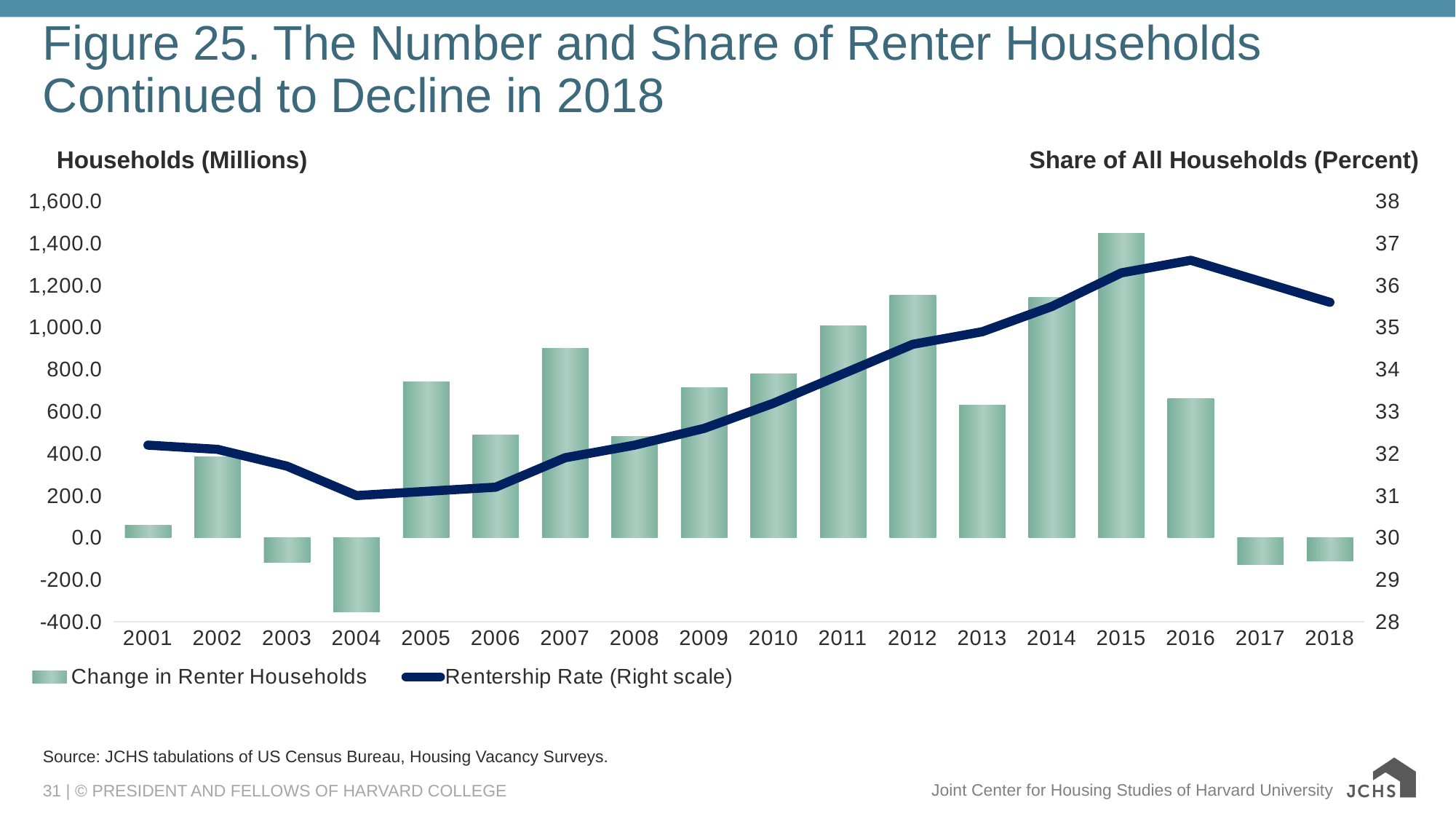
What kind of chart is shown on the slide? A combined bar and line chart How many years are shown on the x axis? 18 Is the Change in Renter Households for 2004 greater or less than -200.0? less How many series does the legend list? 2 Is the Rentership Rate for 2018 greater or less than 35? greater Is the Rentership Rate for 2004 greater or less than 32? less Does the Rentership Rate rise or fall between 2004 and 2016? rise In which year is the Change in Renter Households bar the highest? 2015 Which year has the larger Change in Renter Households, 2011 or 2013? 2011 In which year does the Rentership Rate line reach its highest point? 2016 In which year is the Change in Renter Households bar the lowest? 2004